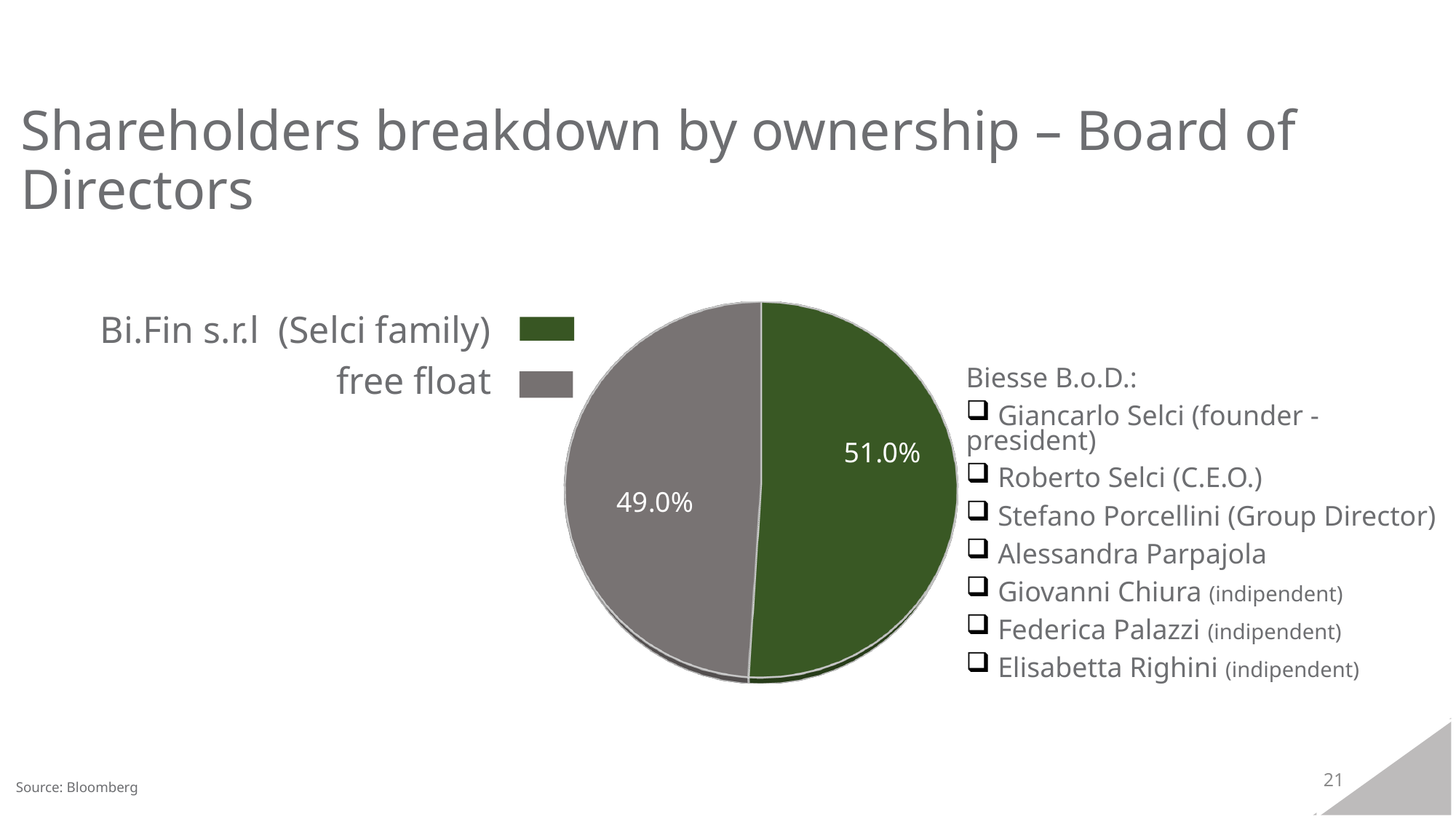
How many entries does the chart legend list? 2 Which slice of the pie chart is the largest? Bi.Fin s.r.l (Selci family) What colour represents Bi.Fin s.r.l (Selci family) in the pie chart? green Which is larger, the Bi.Fin s.r.l (Selci family) share or the free float share? Bi.Fin s.r.l (Selci family) What is the difference between the Bi.Fin s.r.l (Selci family) share and the free float share? 2.0% How many slices does the pie chart have? 2 What share of ownership is free float according to the pie chart? 49.0% What share of ownership does Bi.Fin s.r.l (Selci family) hold according to the pie chart? 51.0% What is the total of the two slices shown in the pie chart? 100.0% What type of chart is shown on the slide? pie chart What colour represents free float in the pie chart? grey Which slice of the pie chart is the smallest? free float